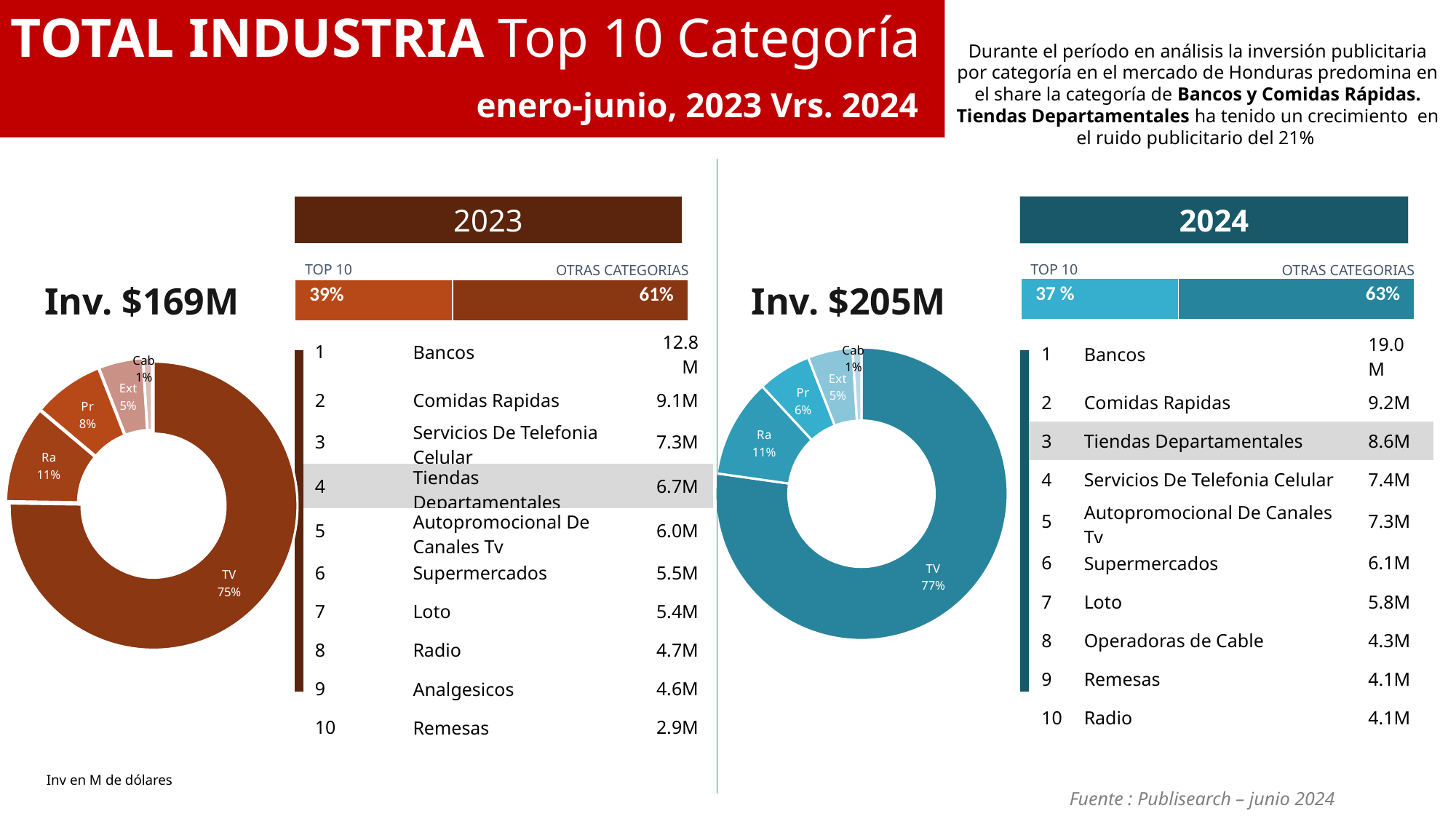
In the 2023 donut chart, which segment is the smallest? Cab What kind of chart is used to show the media shares for 2023 and 2024? Donut chart In the 2024 donut chart, which segment is the largest? TV In the 2024 donut chart, what share does Ra have? 11% In the 2023 stacked bar, what share do Otras Categorias have? 61% In the 2023 donut chart, what share does Pr have? 8% In the 2024 donut chart, which is larger, the Pr share or the Ext share? Pr In the 2023 donut chart, what share does TV have? 75% In the 2023 donut chart, what is the difference between the TV share and the Ra share? 64% In the 2024 stacked bar, what share do the Top 10 categories have? 37 % How many segments does the 2023 donut chart have? 5 In the 2024 donut chart, what share does TV have? 77%